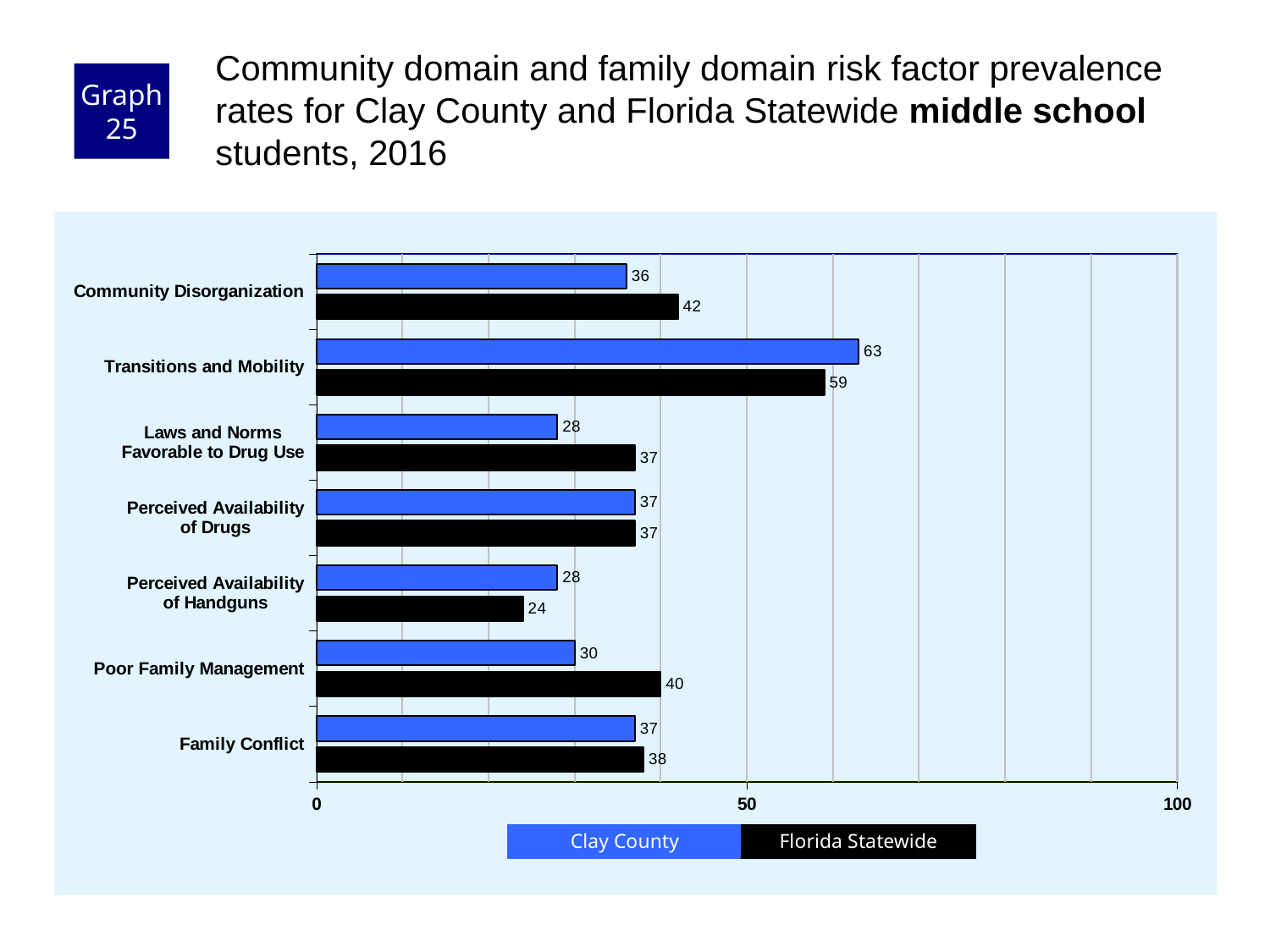
What is the Florida Statewide value for Poor Family Management? 40 Which risk factor has the highest Clay County value? Transitions and Mobility Is the Clay County value for Transitions and Mobility greater or less than 50? greater How many risk factor categories are shown on the chart? 7 How many series does the legend list? 2 Which risk factor has the lowest Florida Statewide value? Perceived Availability of Handguns What is the difference between the Florida Statewide and Clay County values for Laws and Norms Favorable to Drug Use? 9 Which colour represents Florida Statewide in the chart? black What kind of chart is shown on the slide? bar chart What is the Clay County value for Perceived Availability of Handguns? 28 What is the Clay County value for Transitions and Mobility? 63 For Community Disorganization, which is larger: the Clay County value or the Florida Statewide value? Florida Statewide